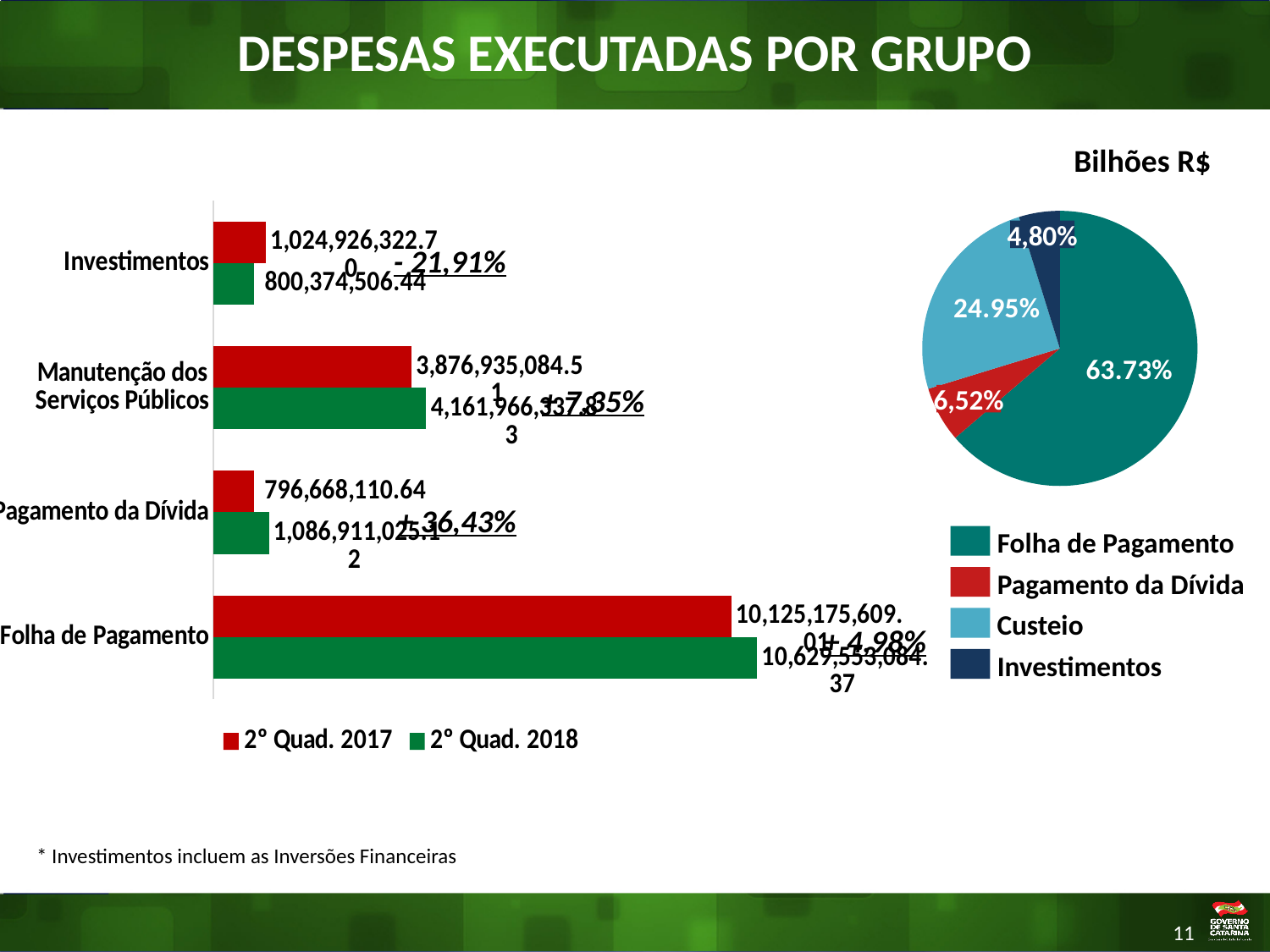
On the bar chart, for Pagamento da Dívida, which is larger: 2° Quad. 2017 or 2° Quad. 2018? 2° Quad. 2018 On the pie chart, what share does Folha de Pagamento have? 63.73% On the bar chart, which category has the lowest value in 2° Quad. 2017? Pagamento da Dívida On the pie chart, which slice is the smallest? Investimentos On the pie chart, what share does Custeio have? 24.95% On the bar chart, what is the value for Pagamento da Dívida in 2° Quad. 2017? 796,668,110.64 How many series does the bar chart's legend list? 2 How many categories are shown on the bar chart? 4 On the bar chart, which category has the highest values? Folha de Pagamento On the bar chart, what is the value for Investimentos in 2° Quad. 2018? 800,374,506.44 What kind of chart is the chart on the left of the slide? Bar chart On the bar chart, for Investimentos, which is larger: 2° Quad. 2017 or 2° Quad. 2018? 2° Quad. 2017